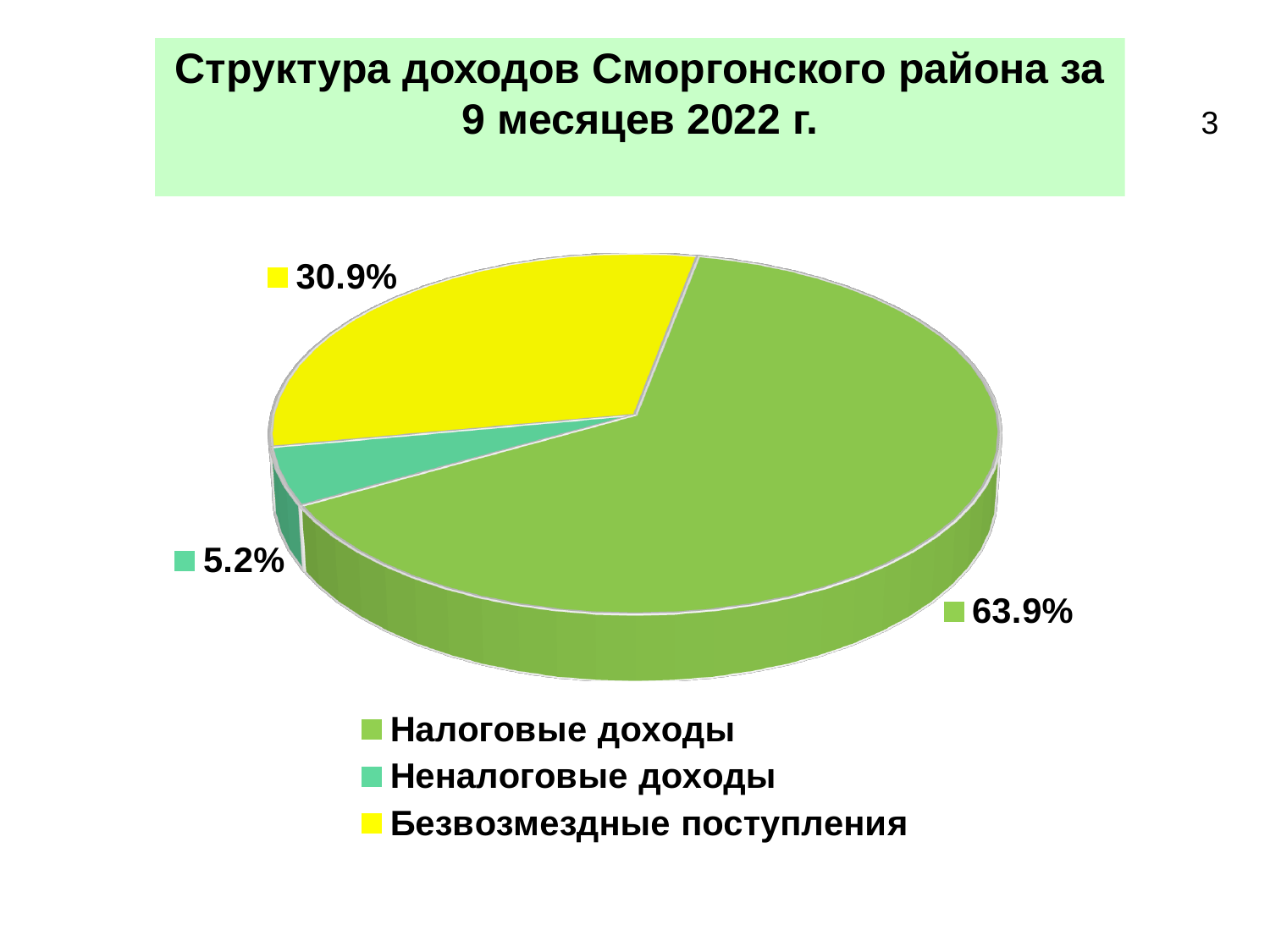
How many slices does the pie chart have? 3 What is the title of the chart? Структура доходов Сморгонского района за 9 месяцев 2022 г. What share of the pie does Неналоговые доходы have? 5.2% Which category has the largest slice of the pie? Налоговые доходы What share of the pie does Безвозмездные поступления have? 30.9% What share of the pie does Налоговые доходы have? 63.9% Which is larger: the share of Безвозмездные поступления or the share of Неналоговые доходы? Безвозмездные поступления What colour is the slice for Безвозмездные поступления? Yellow What is the difference between the shares of Налоговые доходы and Безвозмездные поступления? 33.0% Which category has the smallest slice of the pie? Неналоговые доходы What kind of chart is shown on the slide? Pie chart What is the difference between the shares of Безвозмездные поступления and Неналоговые доходы? 25.7%